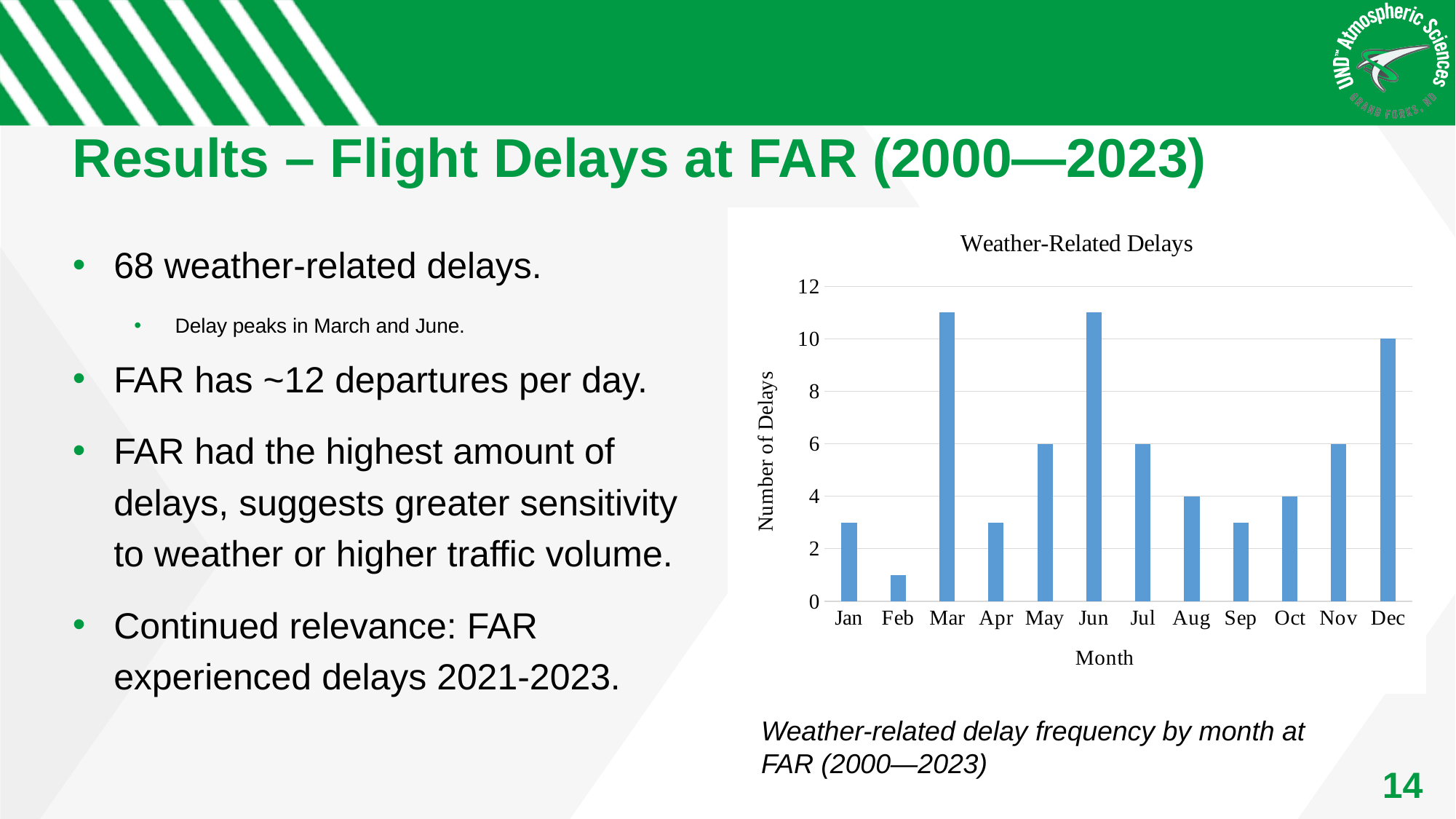
What is the number of delays for Dec? 10 Is the value for Mar greater or less than 10? greater How many months are shown on the x axis of the chart? 12 What kind of chart is shown on the slide? bar chart What is the number of delays for May? 6 What is the number of delays for Aug? 4 What is the label on the vertical axis of the chart? Number of Delays What is the difference in number of delays between Dec and Aug? 6 Is the value for Feb greater or less than 2? less Which month has more delays, Dec or Nov? Dec What is the title of the chart? Weather-Related Delays Which month has the lowest number of delays? Feb